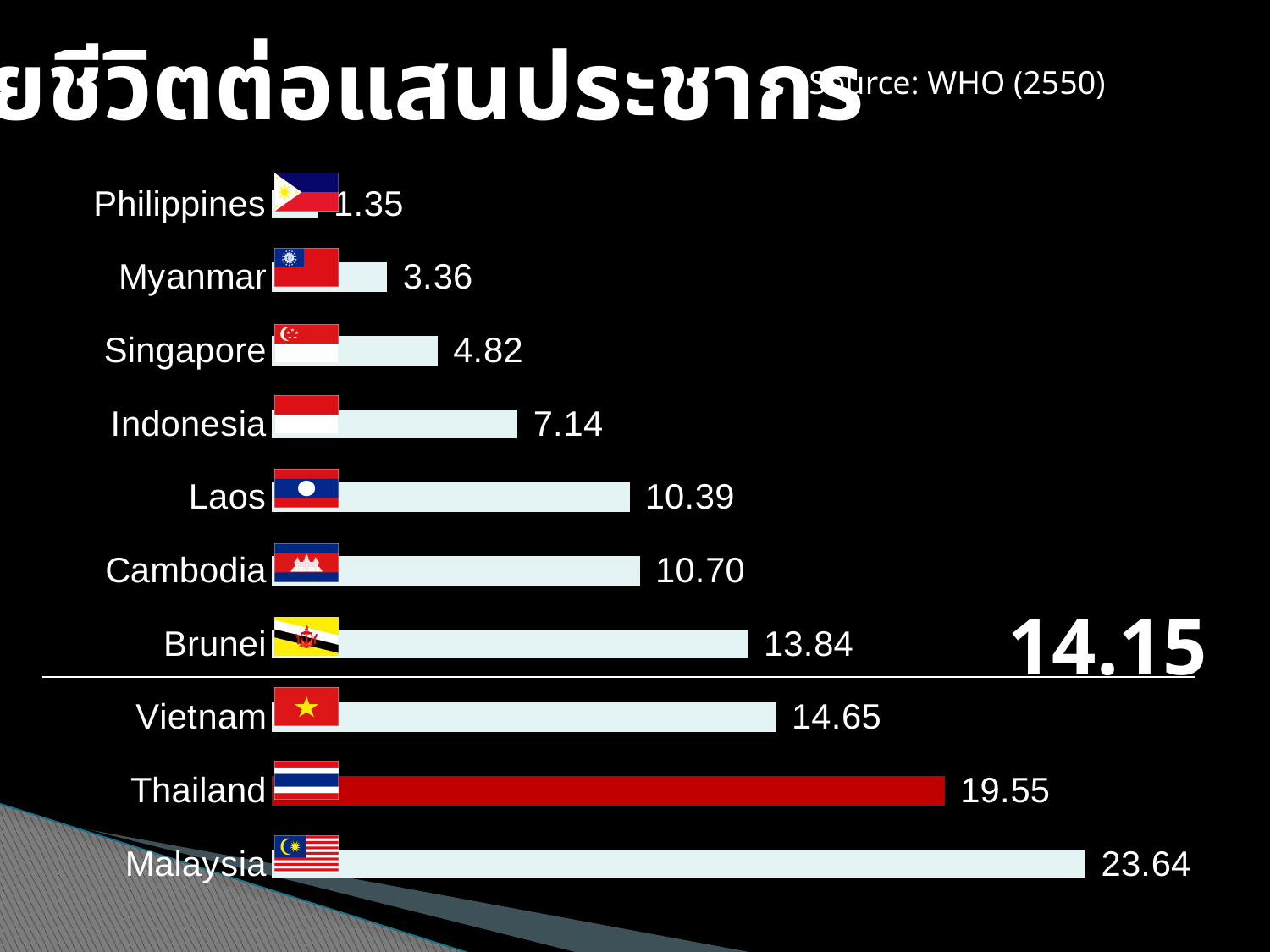
What is the value for Philippines? 1.35 What is the value for Malaysia? 23.64 What is the value for Thailand? 19.55 Which country has the highest value? Malaysia What kind of chart is shown on the slide? Bar chart Which has a larger value, Vietnam or Brunei? Vietnam What is the value for Cambodia? 10.70 Which country's bar is coloured red? Thailand What is the difference between the values for Malaysia and Thailand? 4.09 Which country has the lowest value? Philippines What source is cited on the slide? WHO (2550) How many countries are shown in the chart? 10